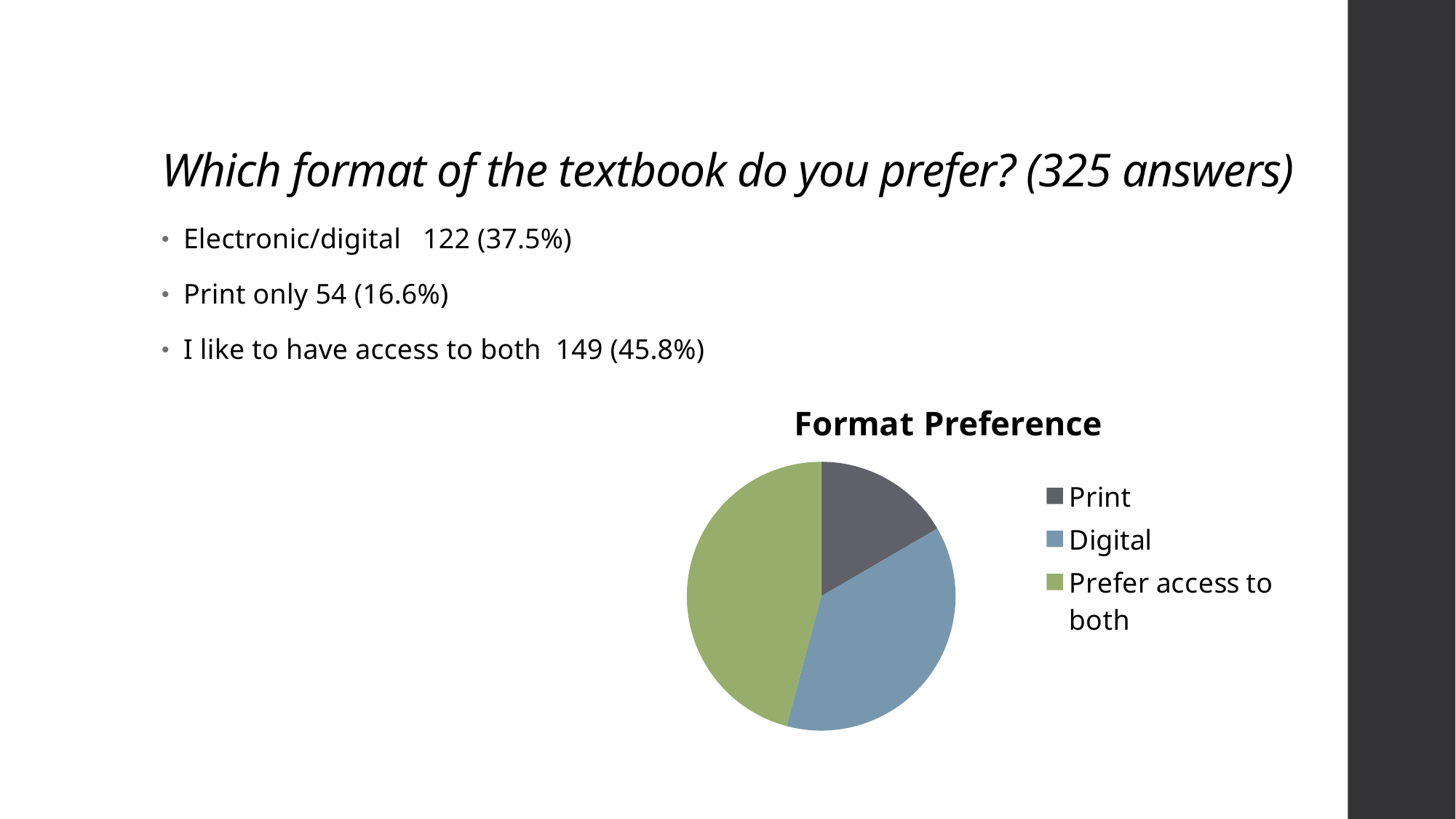
What colour is the Prefer access to both slice in the pie chart? green According to the slide, what share of answers does the Print slice represent? 16.6% According to the slide, how many respondents chose to have access to both formats? 149 Which slice is larger, Prefer access to both or Digital? Prefer access to both What kind of chart is shown on the slide? pie chart How many entries does the chart legend list? 3 According to the slide, what share of answers does the Digital slice represent? 37.5% Which category has the largest slice of the pie? Prefer access to both What is the title of the chart? Format Preference Which slice is larger, Digital or Print? Digital Which category has the smallest slice of the pie? Print How many slices does the pie chart have? 3